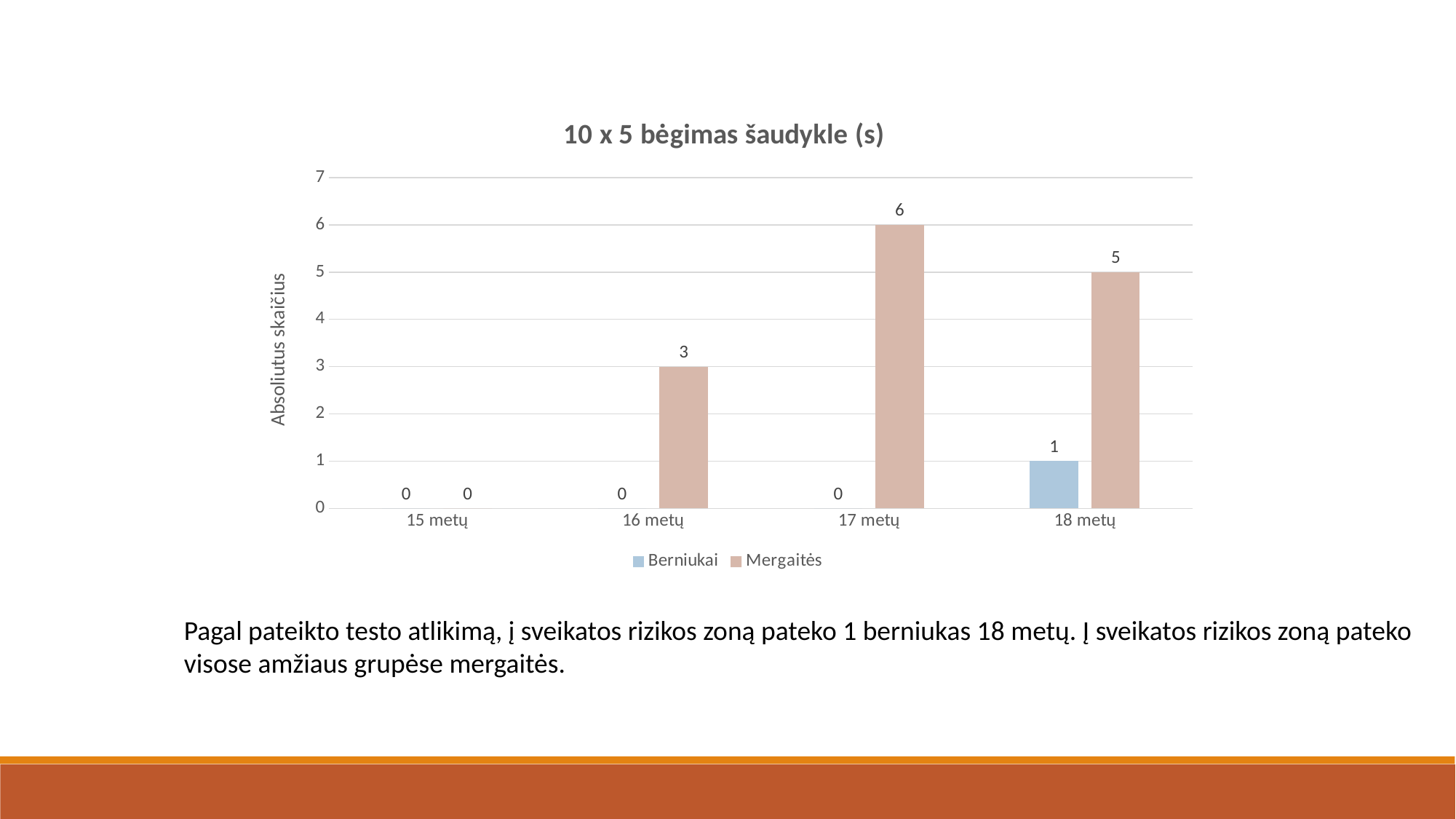
What is the value for Mergaitės at 16 metų? 3 What is the title of the chart? 10 x 5 bėgimas šaudykle (s) What kind of chart is shown? Bar chart What is the value for Berniukai at 18 metų? 1 Which is larger at 18 metų: Berniukai or Mergaitės? Mergaitės How many series does the legend list? 2 How many age groups are shown on the x axis? 4 What is the label of the y axis? Absoliutus skaičius Which age group has the highest value for Mergaitės? 17 metų Which age group has the lowest value for Mergaitės? 15 metų What is the difference between the Mergaitės values at 17 metų and 18 metų? 1 What is the value for Mergaitės at 17 metų? 6